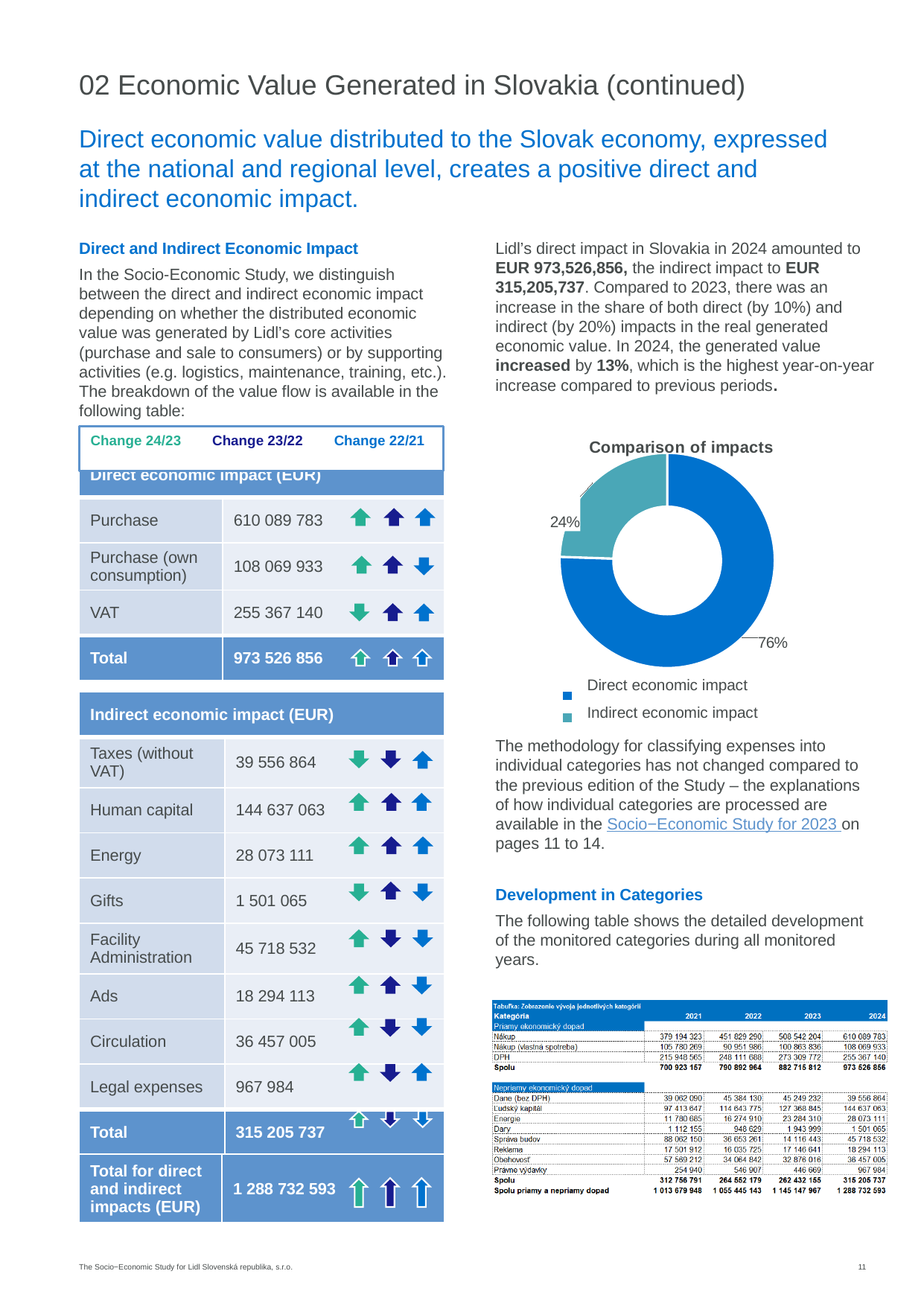
Which slice is the largest in the "Comparison of impacts" chart? Direct economic impact In the "Comparison of impacts" chart, is the share for Indirect economic impact greater or less than 50%? less In the "Comparison of impacts" chart, which legend entry is shown in the lighter teal colour? Indirect economic impact What kind of chart is "Comparison of impacts"? Pie (donut) chart In the "Comparison of impacts" chart, what share does Direct economic impact have? 76% Which slice is the smallest in the "Comparison of impacts" chart? Indirect economic impact What is the title of the pie chart on the slide? Comparison of impacts How many entries does the legend of the "Comparison of impacts" chart list? 2 How many slices does the "Comparison of impacts" chart have? 2 In the "Comparison of impacts" chart, which is larger: Direct economic impact or Indirect economic impact? Direct economic impact In the "Comparison of impacts" chart, what is the difference in percentage points between the Direct and Indirect economic impact shares? 52 In the "Comparison of impacts" chart, what share does Indirect economic impact have? 24%